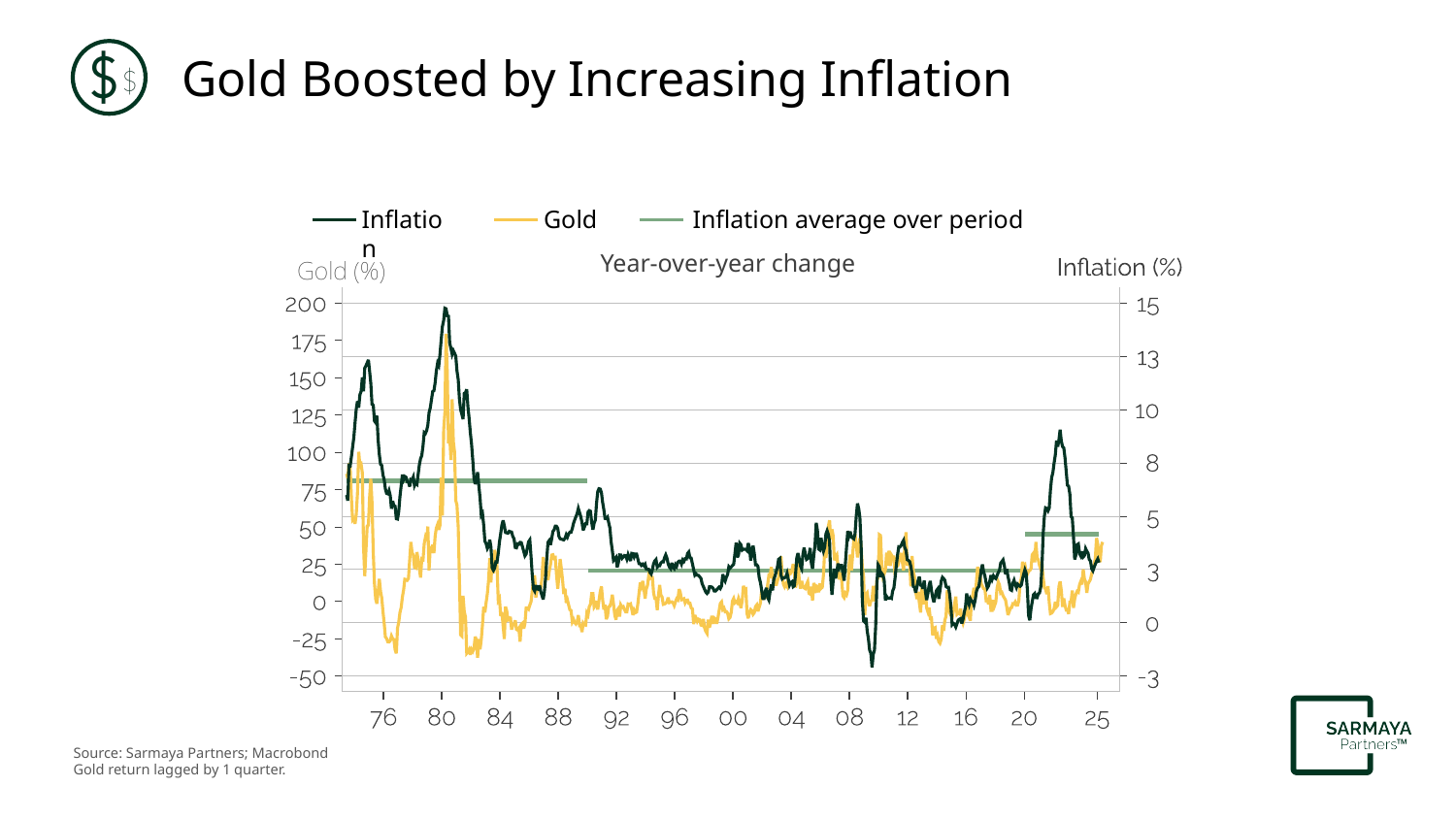
Is the Inflation value at its low point around 2009 greater or less than 0 on the right axis? less Does the Inflation series rise or fall between its 2022 peak and 2025? fall Is the first (leftmost) Inflation average over period line greater or less than 5 on the right axis? greater Is the Gold value at its low point around 2013 greater or less than 0 on the left axis? less What is the title of the right-hand vertical axis? Inflation (%) How many series does the legend list? 3 What kind of chart is shown on the slide? line chart What is the title of the chart? Year-over-year change Does the Gold series rise or fall between 1977 and its 1980 peak? rise